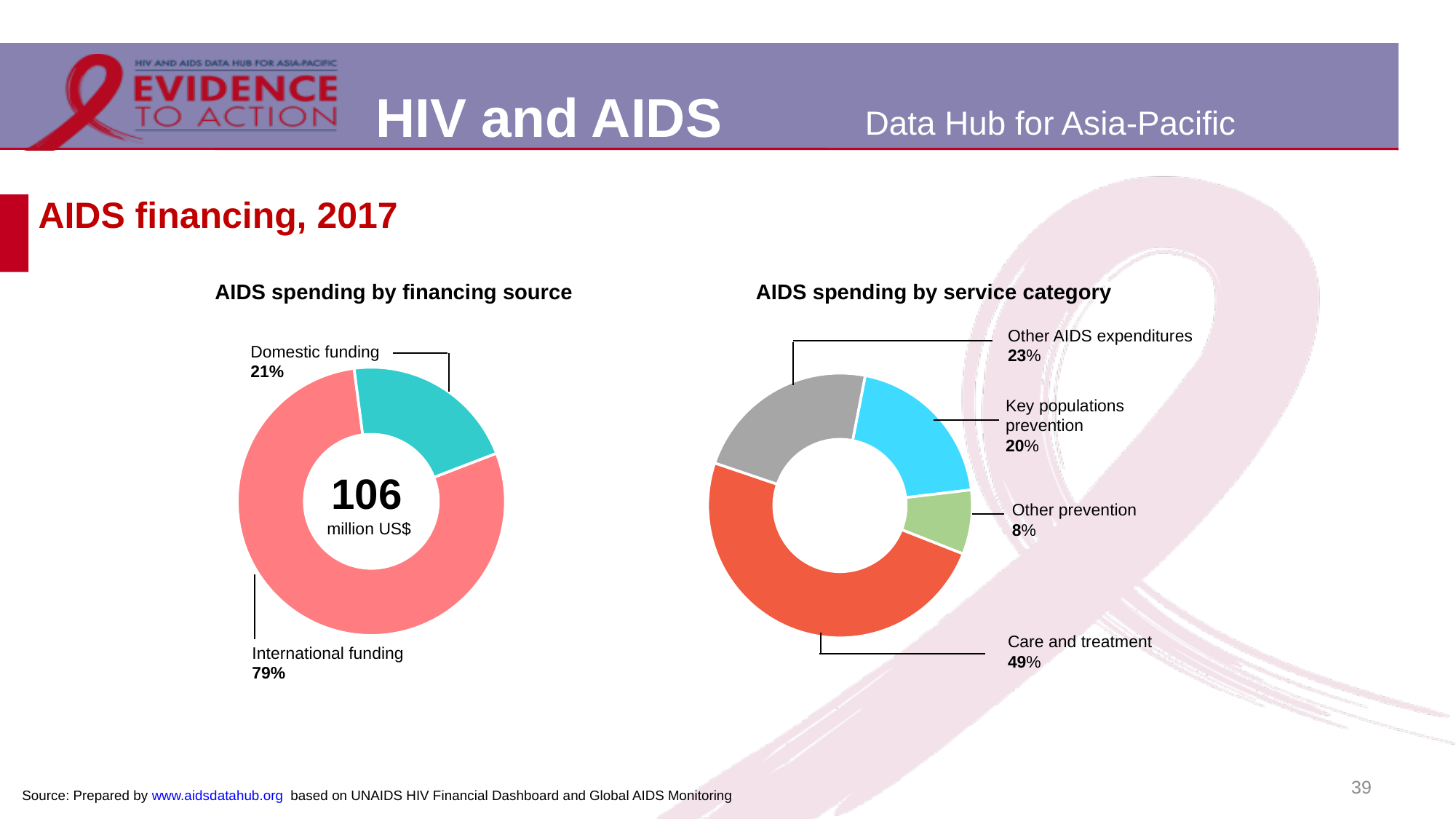
In the 'AIDS spending by financing source' chart, what share is International funding? 79% In the 'AIDS spending by service category' chart, which service category has the smallest share? Other prevention What type of chart is used for 'AIDS spending by financing source'? Donut (pie) chart In the 'AIDS spending by service category' chart, what share is Care and treatment? 49% In the 'AIDS spending by financing source' chart, which financing source has the larger share? International funding In the 'AIDS spending by financing source' chart, what total value is shown in the centre of the donut? 106 million US$ How many service categories are shown in the 'AIDS spending by service category' chart? 4 In the 'AIDS spending by financing source' chart, what share is Domestic funding? 21% In the 'AIDS spending by financing source' chart, what is the difference in percentage points between International funding and Domestic funding? 58 In the 'AIDS spending by service category' chart, which service category has the largest share? Care and treatment In the 'AIDS spending by service category' chart, what share is Key populations prevention? 20% In the 'AIDS spending by service category' chart, which is larger: Other AIDS expenditures or Key populations prevention? Other AIDS expenditures